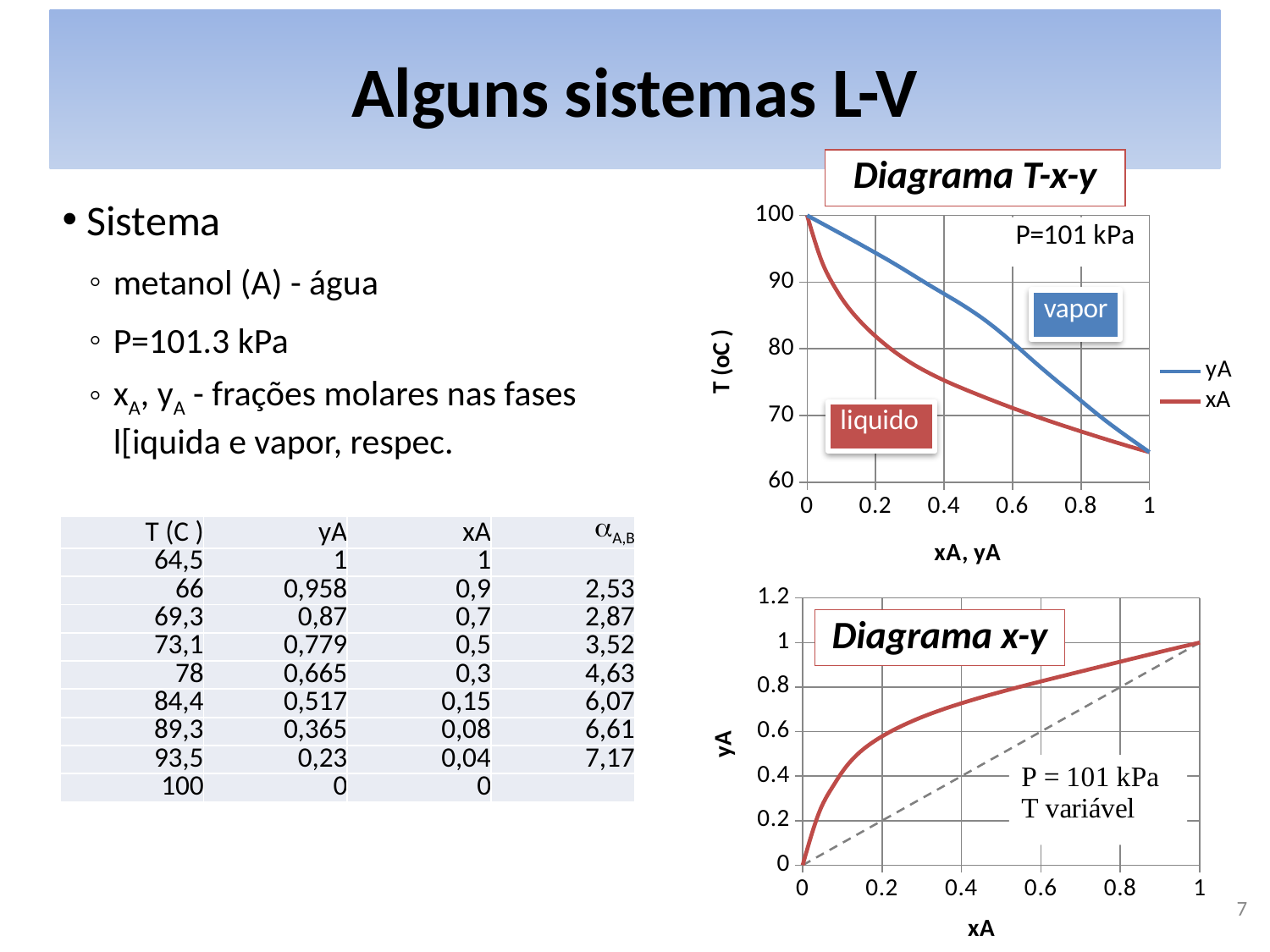
What kind of chart is the Diagrama x-y? line chart In the Diagrama T-x-y, does the xA curve rise or fall as xA increases from 0 to 1? fall In the Diagrama T-x-y, is the yA curve at yA = 0.4 greater or less than 80? greater What kind of chart is the Diagrama T-x-y? line chart In the Diagrama x-y, what is yA at xA = 1? 1 In the Diagrama T-x-y, is the xA curve at xA = 0.2 greater or less than 90? less In the Diagrama x-y, does yA rise or fall as xA increases? rise In the Diagrama x-y, is yA at xA = 0.2 greater or less than 0.4? greater In the Diagrama T-x-y, what is T (oC) at xA, yA = 0? 100 How many series does the legend of the Diagrama T-x-y list? 2 In the Diagrama T-x-y, at a horizontal-axis value of 0.4, which curve shows the higher temperature, yA or xA? yA In the Diagrama T-x-y, what are the two legend entries? yA and xA